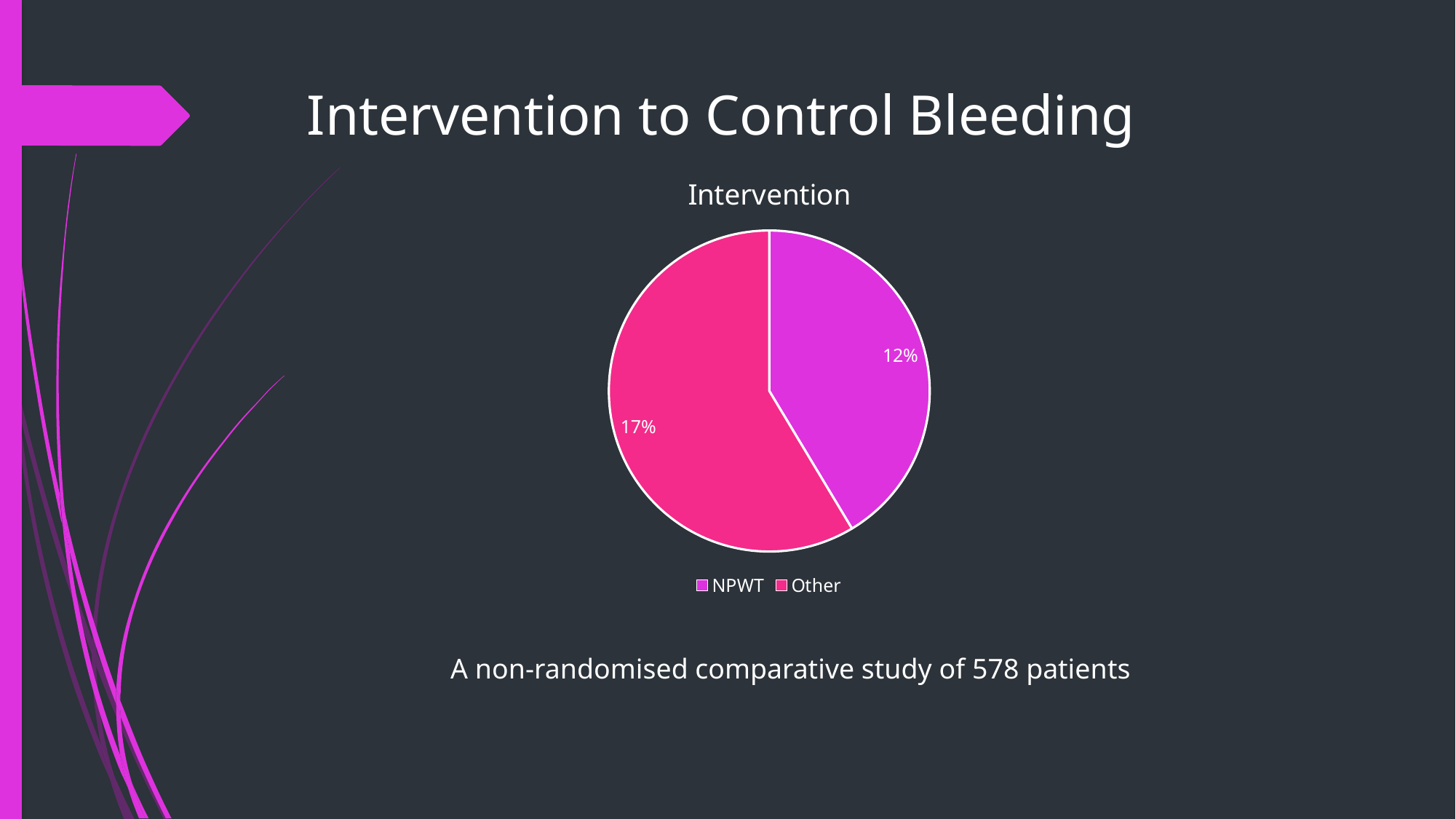
What value is labelled on the NPWT slice? 12% What is the title of the chart? Intervention How many slices does the pie chart have? 2 Which legend entry is shown in the purple colour? NPWT Which slice of the pie is the smallest? NPWT What value is labelled on the Other slice? 17% What type of chart is shown on the slide? pie chart Which is larger, the NPWT slice or the Other slice? Other What is the difference between the labelled values for Other and NPWT? 5% How many entries does the legend list? 2 Which slice of the pie is the largest? Other